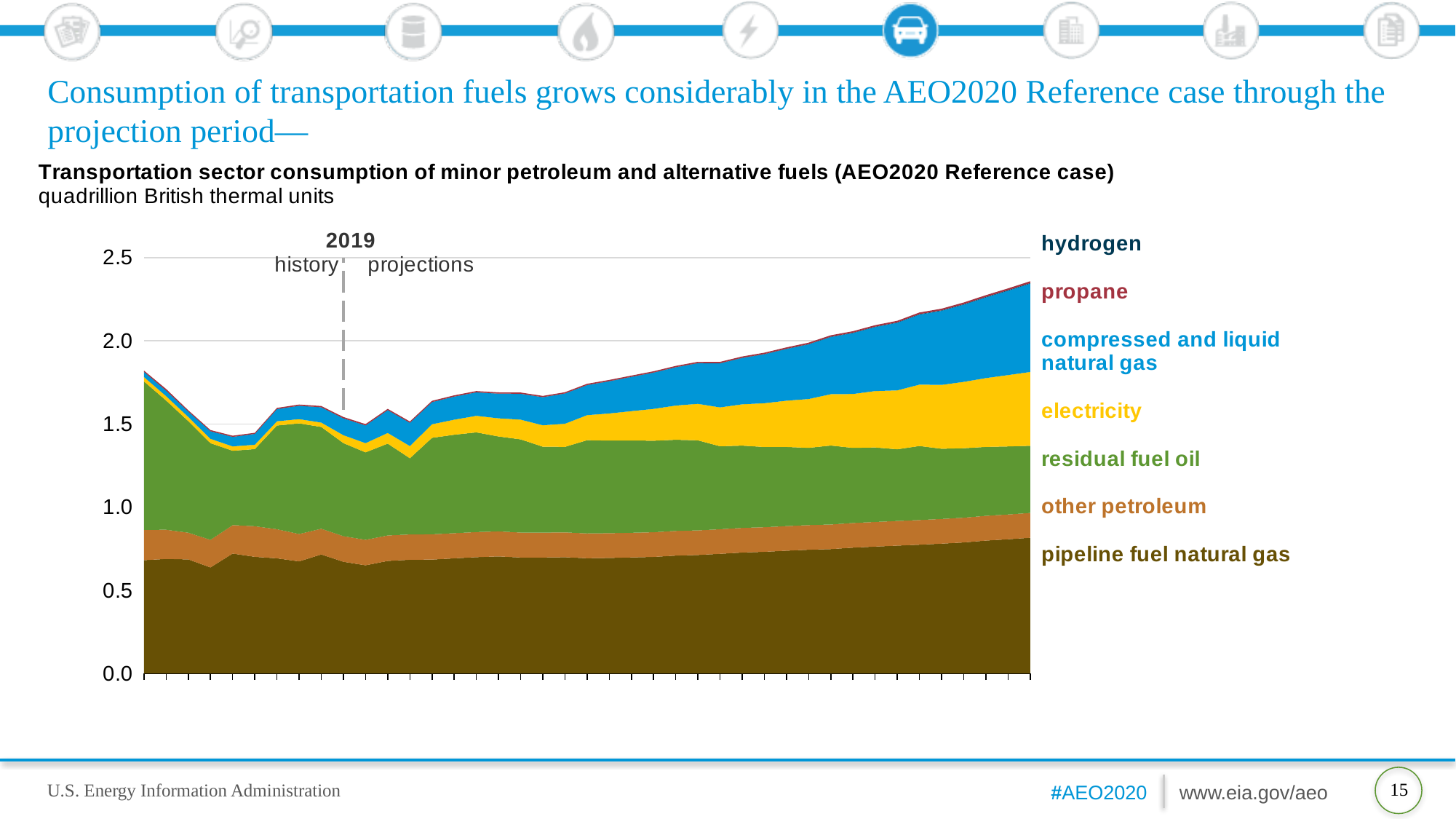
Which year separates history from projections on the chart? 2019 What kind of chart is shown on the slide? stacked area chart At the end of the projection period, which is larger: pipeline fuel natural gas or other petroleum? pipeline fuel natural gas What is the title of the chart? Transportation sector consumption of minor petroleum and alternative fuels (AEO2020 Reference case) Which fuel series is the largest at the end of the projection period? pipeline fuel natural gas How many fuel series does the legend list? 7 Does total consumption rise or fall over the projection period after 2019? rise Which series is shown at the bottom of the stacked areas? pipeline fuel natural gas Is the value for pipeline fuel natural gas at the end of the projection period greater or less than 0.5? greater Is the total consumption at the end of the projection period greater or less than 2.0? greater What unit is the y axis measured in? quadrillion British thermal units Is the total consumption at the start of the chart greater or less than 2.0? less